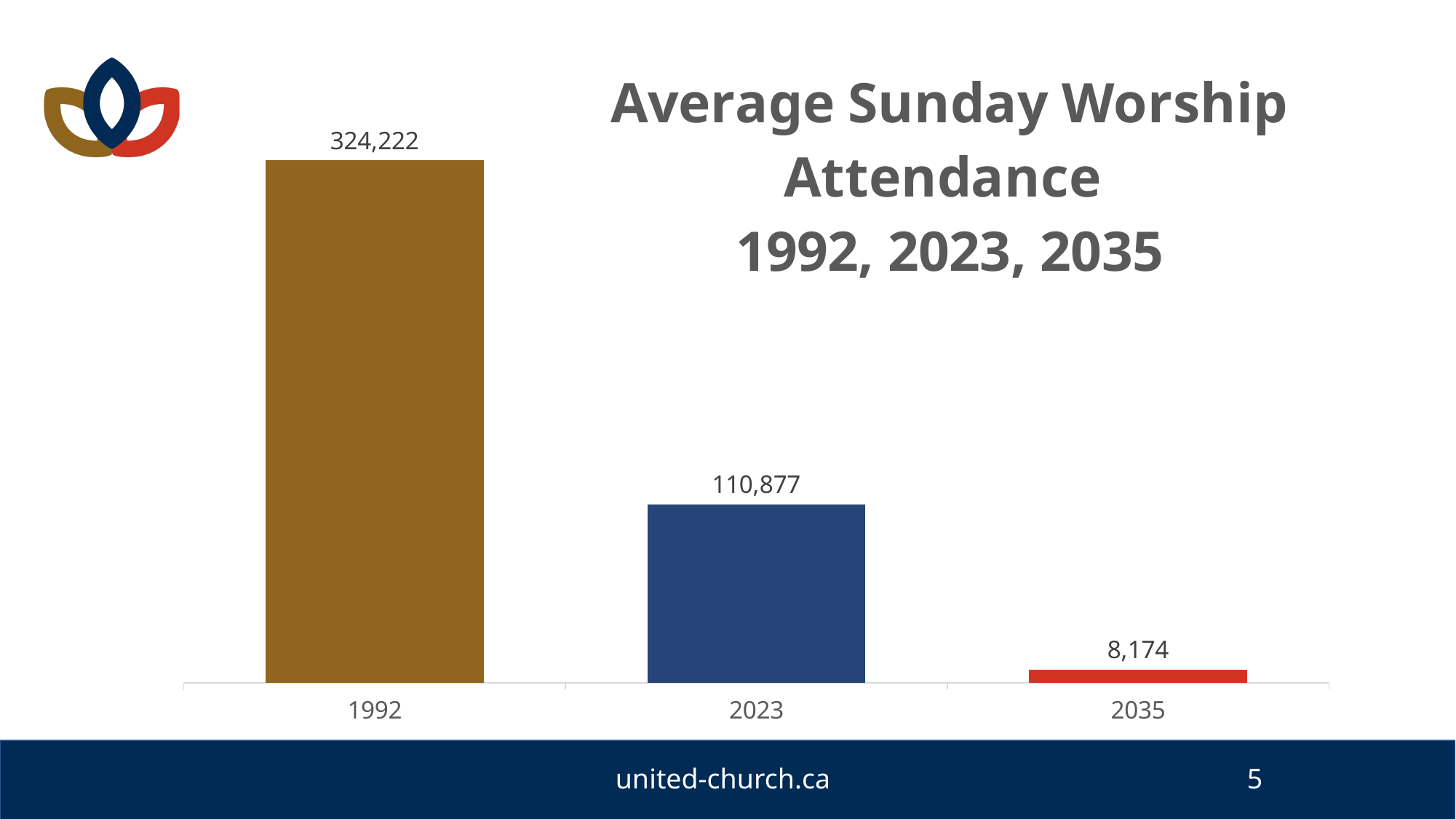
Which year has the lowest average Sunday worship attendance? 2035 What is the difference in attendance between 1992 and 2023? 213,345 What is the average Sunday worship attendance shown for 1992? 324,222 What is the average Sunday worship attendance shown for 2023? 110,877 Do the attendance values rise or fall from 1992 to 2035? Fall What kind of chart is shown on the slide? Bar chart How many years are shown on the chart? 3 What is the title of the chart? Average Sunday Worship Attendance 1992, 2023, 2035 What is the difference in attendance between 2023 and 2035? 102,703 Which is larger, the attendance for 2023 or for 2035? 2023 Which year has the highest average Sunday worship attendance? 1992 What is the average Sunday worship attendance shown for 2035? 8,174